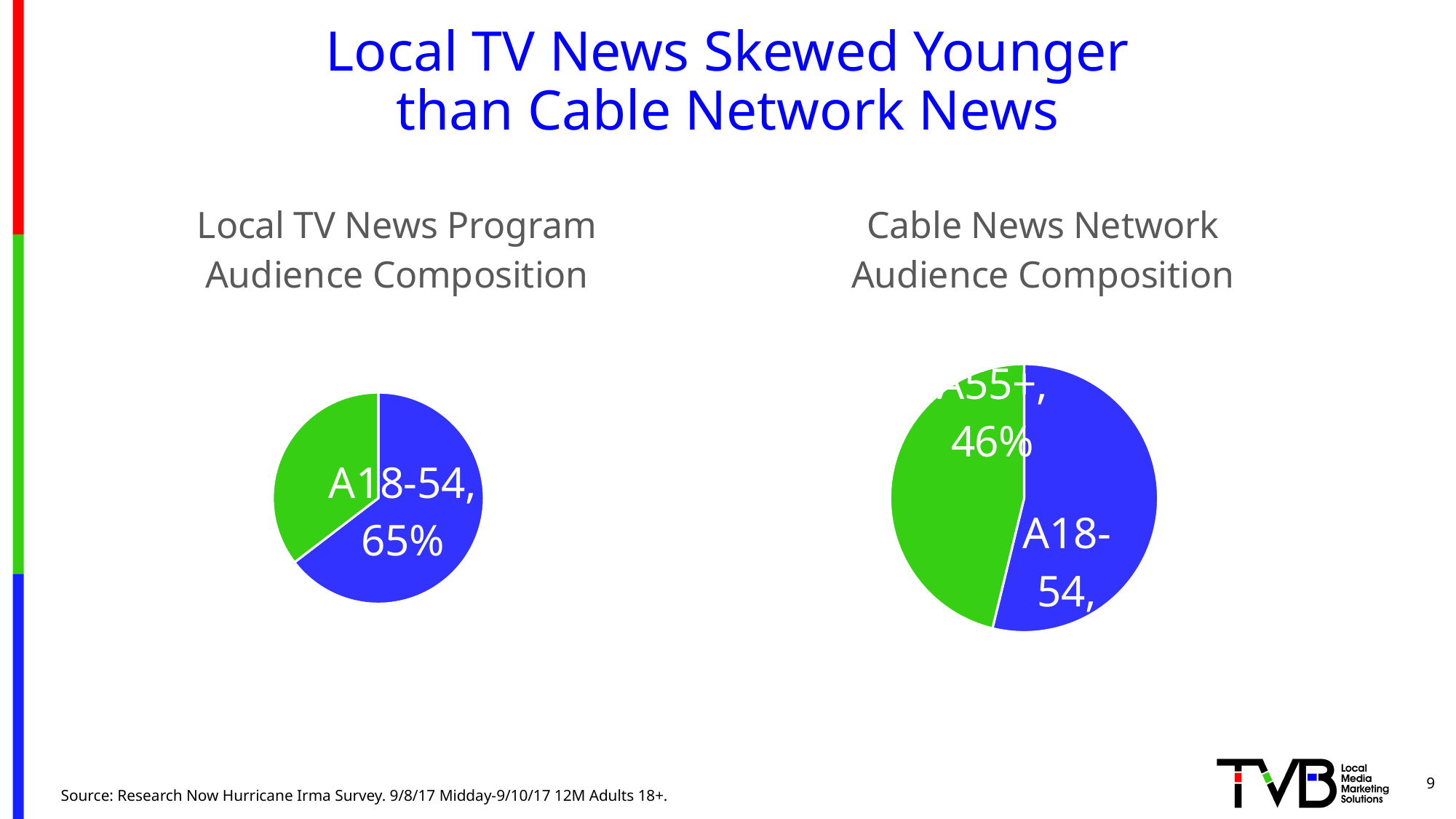
What colour is the A18-54 slice in the Local TV News Program Audience Composition pie chart? Blue How many slices does the Local TV News Program Audience Composition pie chart have? 2 In the Cable News Network Audience Composition pie chart, is the A55+ share greater or less than 50%? less In the Local TV News Program Audience Composition pie chart, what share of the audience is A18-54? 65% In the Local TV News Program Audience Composition pie chart, is the A18-54 share greater or less than 50%? greater What kind of chart is used for the Cable News Network Audience Composition? Pie chart What is the title of the pie chart on the right side of the slide? Cable News Network Audience Composition How many slices does the Cable News Network Audience Composition pie chart have? 2 In the Cable News Network Audience Composition pie chart, what share of the audience is A55+? 46% In the Cable News Network Audience Composition pie chart, which slice is larger, A18-54 or A55+? A18-54 What kind of chart is used for the Local TV News Program Audience Composition? Pie chart In the Local TV News Program Audience Composition pie chart, which slice is the largest? A18-54